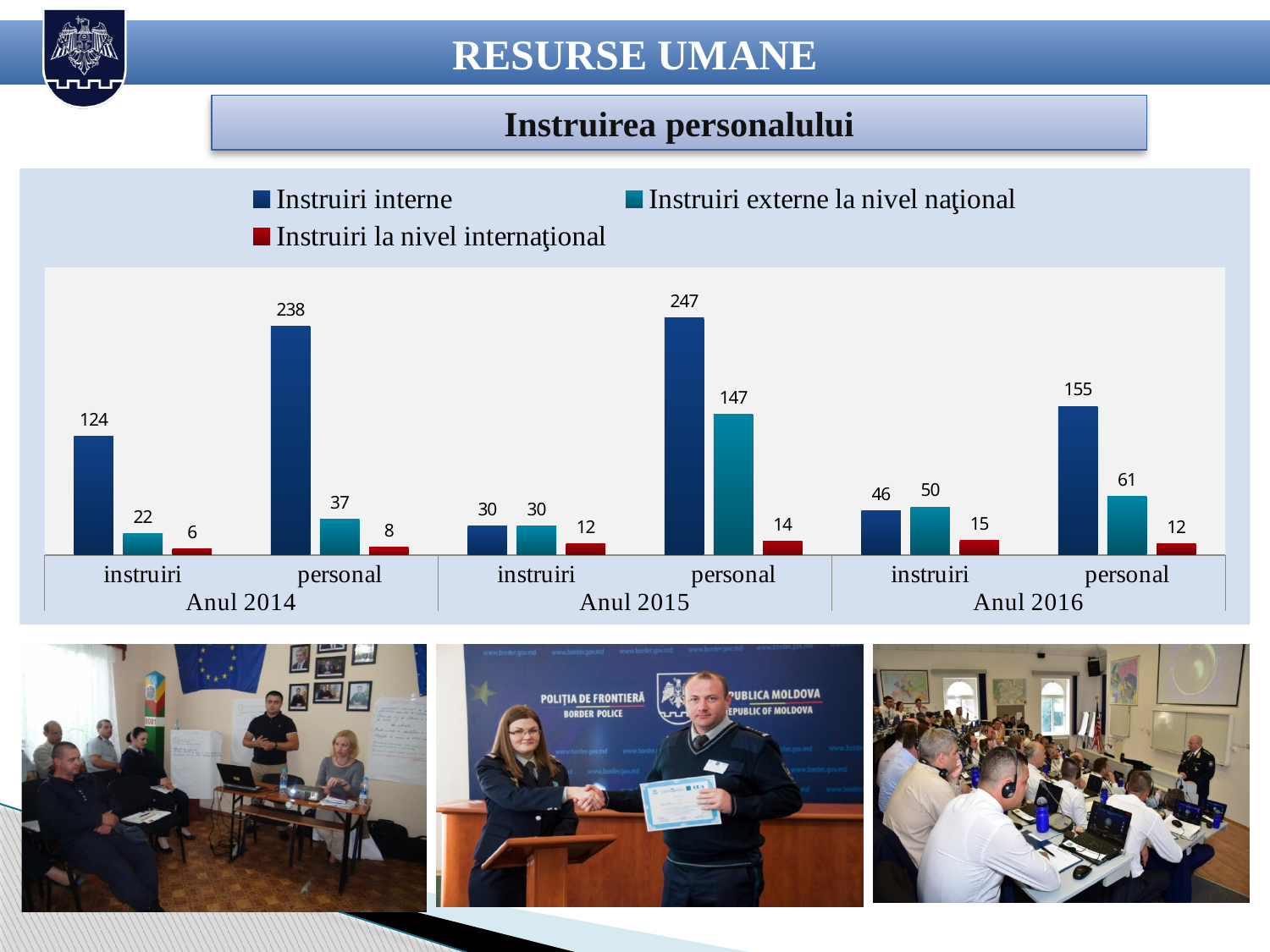
How many series does the legend list? 3 What is the value of Instruiri la nivel internaţional for instruiri in Anul 2016? 15 What is the total of the three series for instruiri in Anul 2015? 72 Which year has the highest value of Instruiri interne for personal? Anul 2015 What is the value of Instruiri externe la nivel naţional for personal in Anul 2015? 147 What is the value of Instruiri interne for personal in Anul 2014? 238 What type of chart is shown on the slide? bar chart What is the difference between Instruiri interne and Instruiri externe la nivel naţional for personal in Anul 2016? 94 What is the title shown above the chart? Instruirea personalului How many year groups are shown on the x axis? 3 Which is larger for instruiri in Anul 2016: Instruiri interne or Instruiri externe la nivel naţional? Instruiri externe la nivel naţional Which year has the lowest value of Instruiri la nivel internaţional for instruiri? Anul 2014